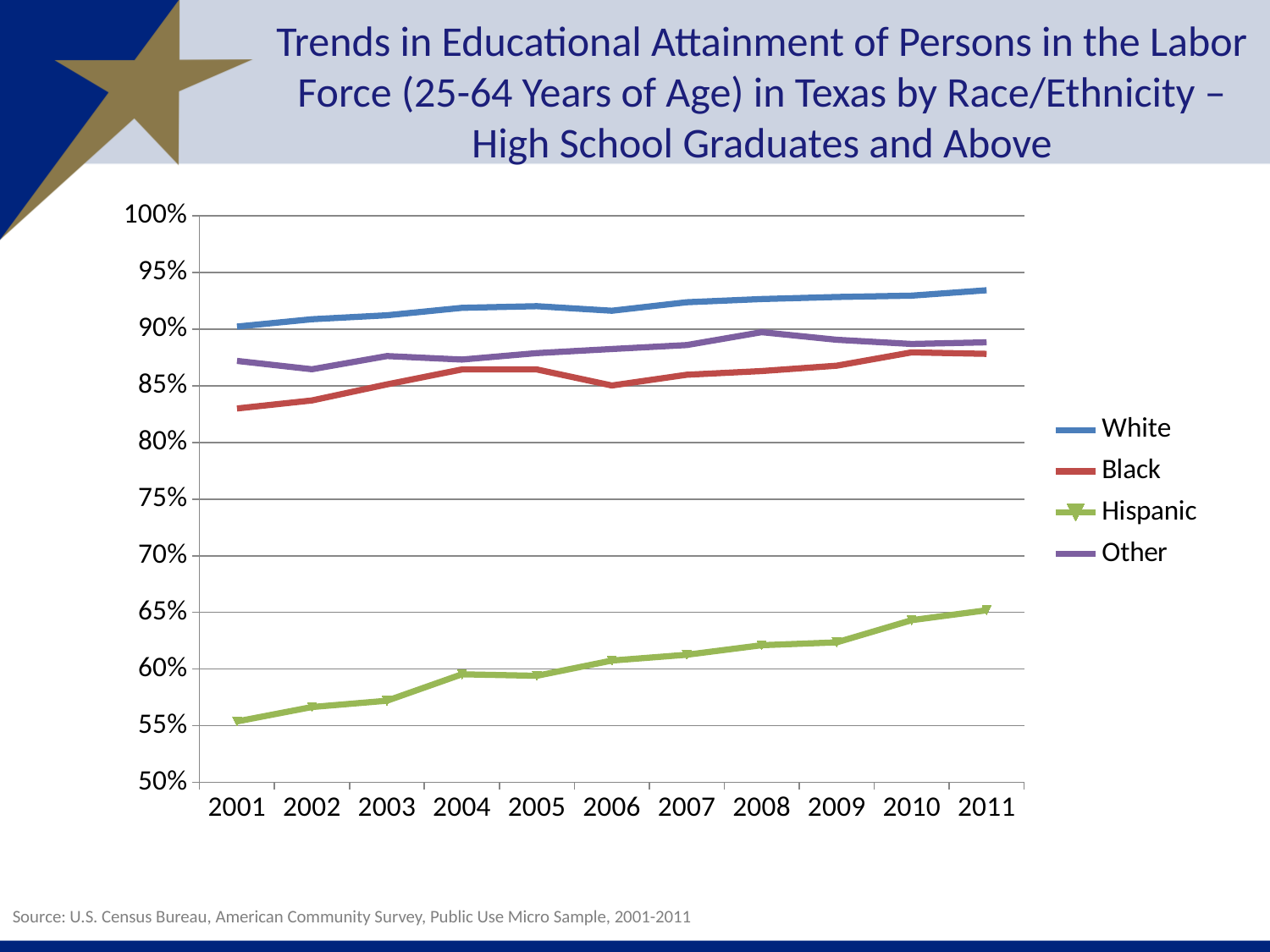
Is the value for Hispanic in 2011 greater or less than 60%? greater Is the value for Hispanic in 2001 greater or less than 60%? less Which series has the lowest value in 2011? Hispanic What are the four entries listed in the legend? White, Black, Hispanic, Other Which series has the highest value in 2011? White What kind of chart is shown on the slide? line chart In 2008, which is higher: the value for Other or the value for Black? Other Is the value for White in 2011 greater or less than 90%? greater Does the Hispanic line rise or fall from 2001 to 2011? rises How many years are shown along the x axis? 11 How many series does the legend list? 4